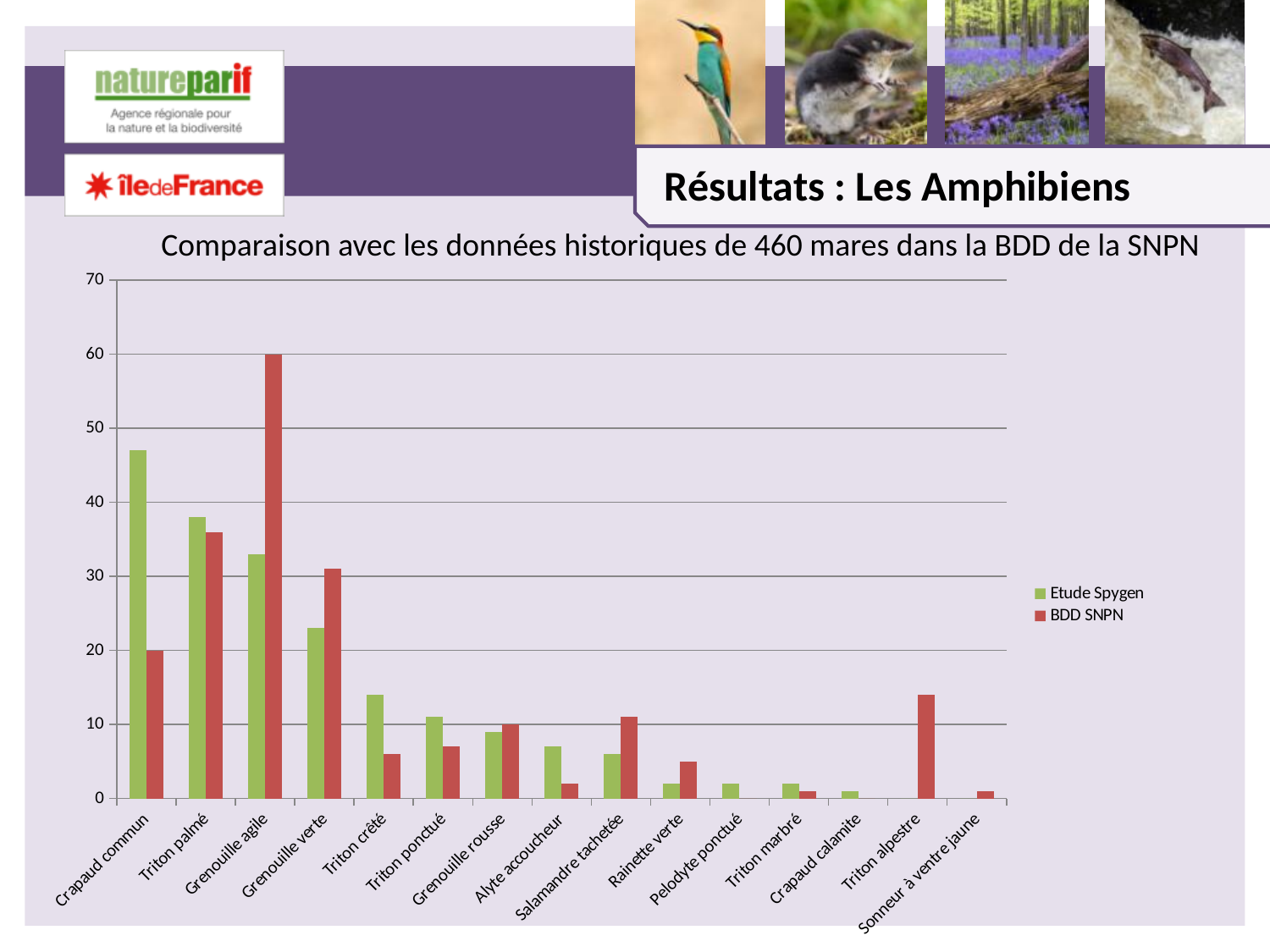
Which species has the highest BDD SNPN value? Grenouille agile For Grenouille verte, which series has the larger value, Etude Spygen or BDD SNPN? BDD SNPN Is the BDD SNPN value for Triton alpestre greater or less than 10? greater What kind of chart is shown on the slide? bar chart Is the Etude Spygen value for Crapaud commun greater or less than 40? greater What is the title of the chart? Comparaison avec les données historiques de 460 mares dans la BDD de la SNPN How many species categories are shown on the x axis? 15 What is the BDD SNPN value for Crapaud commun? 20 What is the BDD SNPN value for Grenouille agile? 60 For Triton crêté, which series has the larger value, Etude Spygen or BDD SNPN? Etude Spygen Which species has the highest Etude Spygen value? Crapaud commun How many series does the legend list? 2